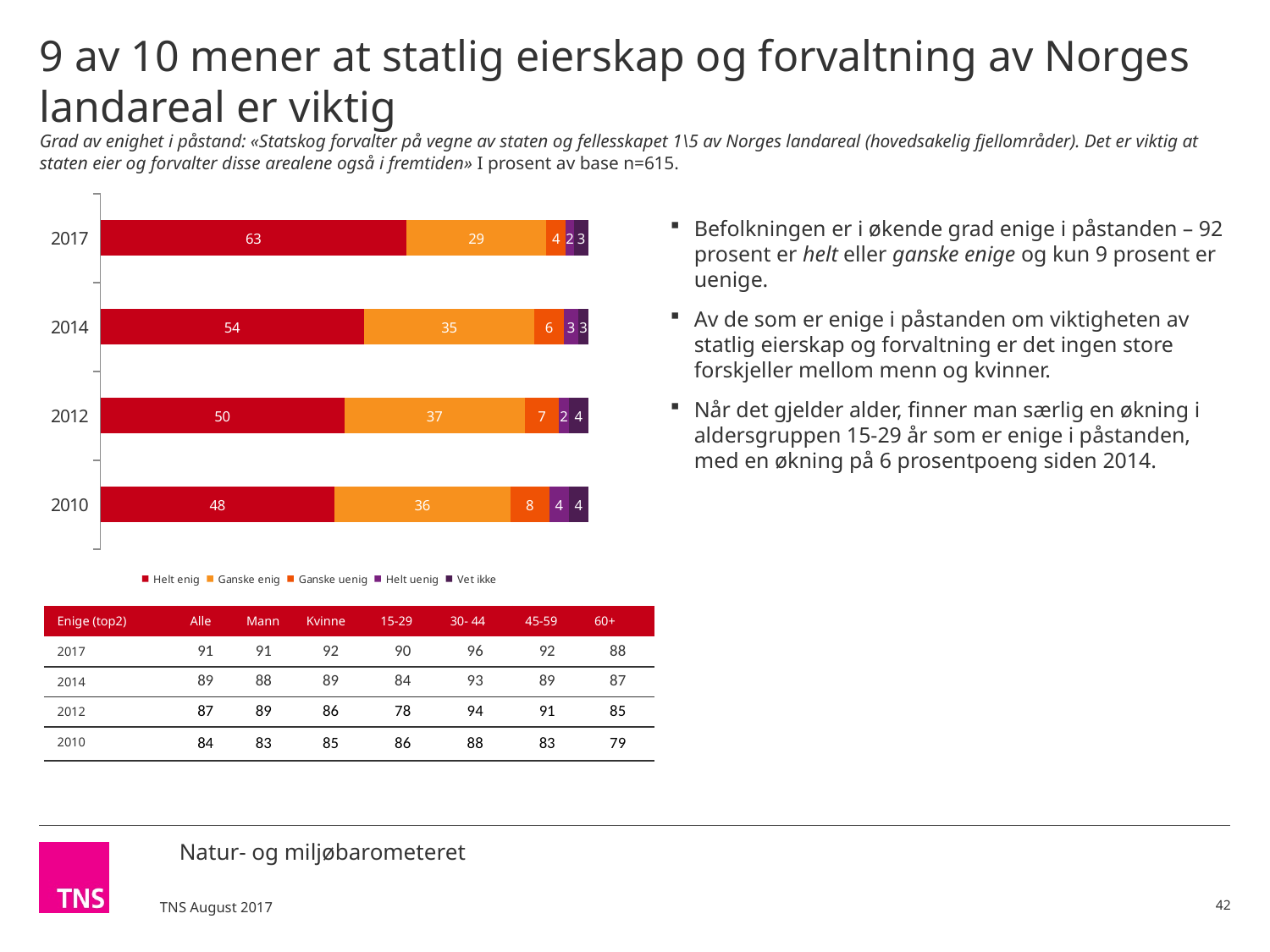
Which year has the lowest value for "Helt enig"? 2010 How many years are shown on the chart? 4 What is the value for "Ganske uenig" in 2010? 8 What is the value for "Ganske enig" in 2012? 37 Which is larger, the "Ganske enig" value for 2012 or for 2010? 2012 What kind of chart is shown on the slide? Stacked bar chart What is the total of the stacked bar for 2012? 100 How many series does the legend list? 5 Which year has the highest value for "Helt enig"? 2017 What is the difference between the "Helt enig" values for 2017 and 2014? 9 What is the value for "Helt enig" in 2017? 63 What is the value for "Helt uenig" in 2014? 3